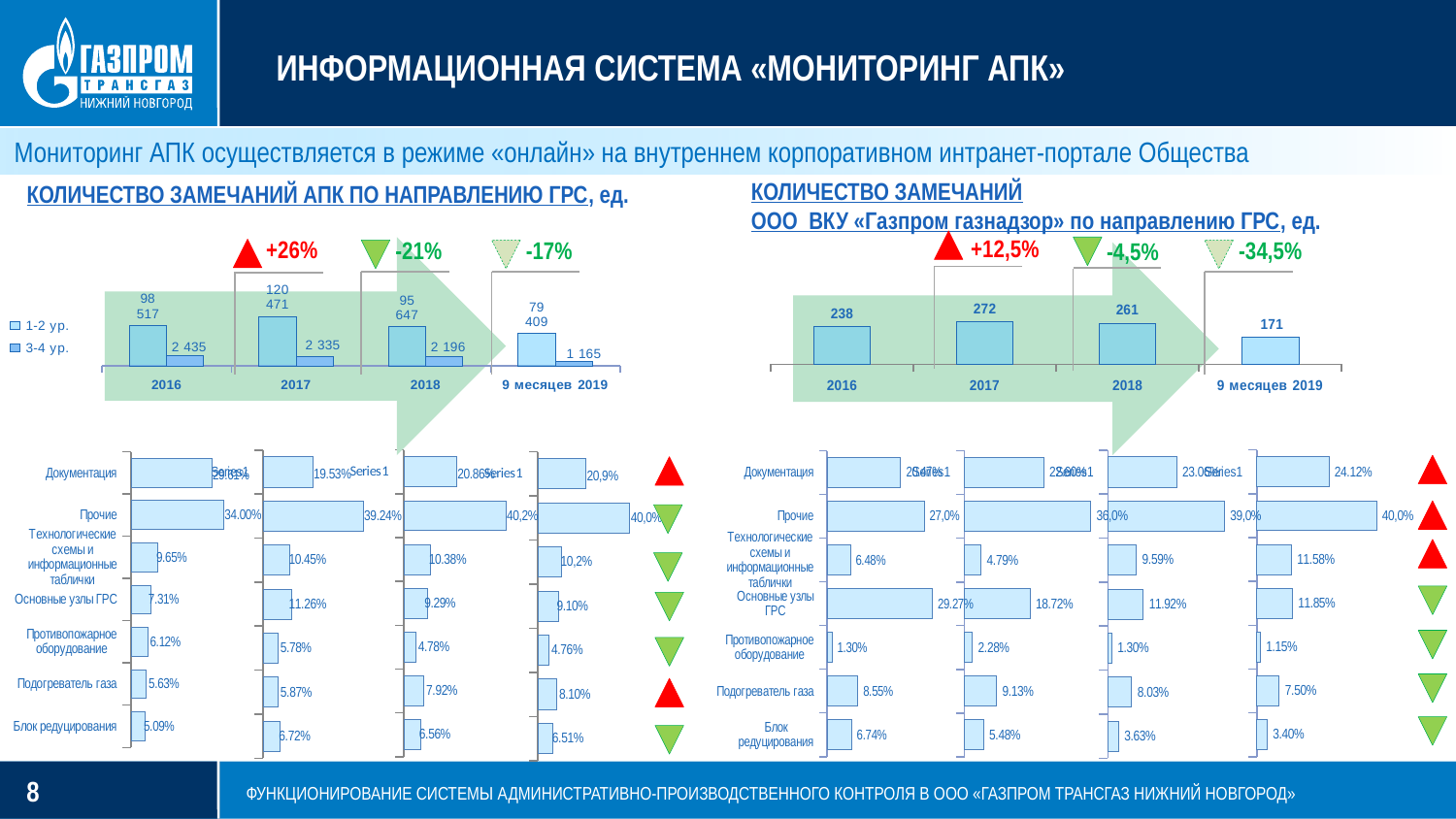
How many series does the legend of the top-left chart (КОЛИЧЕСТВО ЗАМЕЧАНИЙ АПК ПО НАПРАВЛЕНИЮ ГРС) list? 2 In the top-right chart (КОЛИЧЕСТВО ЗАМЕЧАНИЙ ООО ВКУ «Газпром газнадзор»), which year has the highest value? 2017 In the top-right chart (КОЛИЧЕСТВО ЗАМЕЧАНИЙ ООО ВКУ «Газпром газнадзор»), what is the difference between the 2017 and 2016 values? 34 What kind of chart is the top-right chart (КОЛИЧЕСТВО ЗАМЕЧАНИЙ ООО ВКУ «Газпром газнадзор»)? bar chart In the bottom-left group of charts, what is the value for Прочие in the 9 месяцев 2019 chart? 40,0% In the top-right chart (КОЛИЧЕСТВО ЗАМЕЧАНИЙ ООО ВКУ «Газпром газнадзор»), which period has the lowest value? 9 месяцев 2019 How many time periods are shown on the x axis of the top-left chart (КОЛИЧЕСТВО ЗАМЕЧАНИЙ АПК ПО НАПРАВЛЕНИЮ ГРС)? 4 In the top-right chart (КОЛИЧЕСТВО ЗАМЕЧАНИЙ ООО ВКУ «Газпром газнадзор»), what percentage change is shown between 2018 and 9 месяцев 2019? -34,5% In the top-left chart (КОЛИЧЕСТВО ЗАМЕЧАНИЙ АПК ПО НАПРАВЛЕНИЮ ГРС), what is the difference between the 3-4 ур. values for 2016 and 2017? 100 In the bottom-right group of charts, what is the value for Противопожарное оборудование in the 2016 chart? 1.30% In the top-right chart (КОЛИЧЕСТВО ЗАМЕЧАНИЙ ООО ВКУ «Газпром газнадзор»), what is the value for 2017? 272 In the top-left chart (КОЛИЧЕСТВО ЗАМЕЧАНИЙ АПК ПО НАПРАВЛЕНИЮ ГРС), what is the 3-4 ур. value for 2018? 2 196